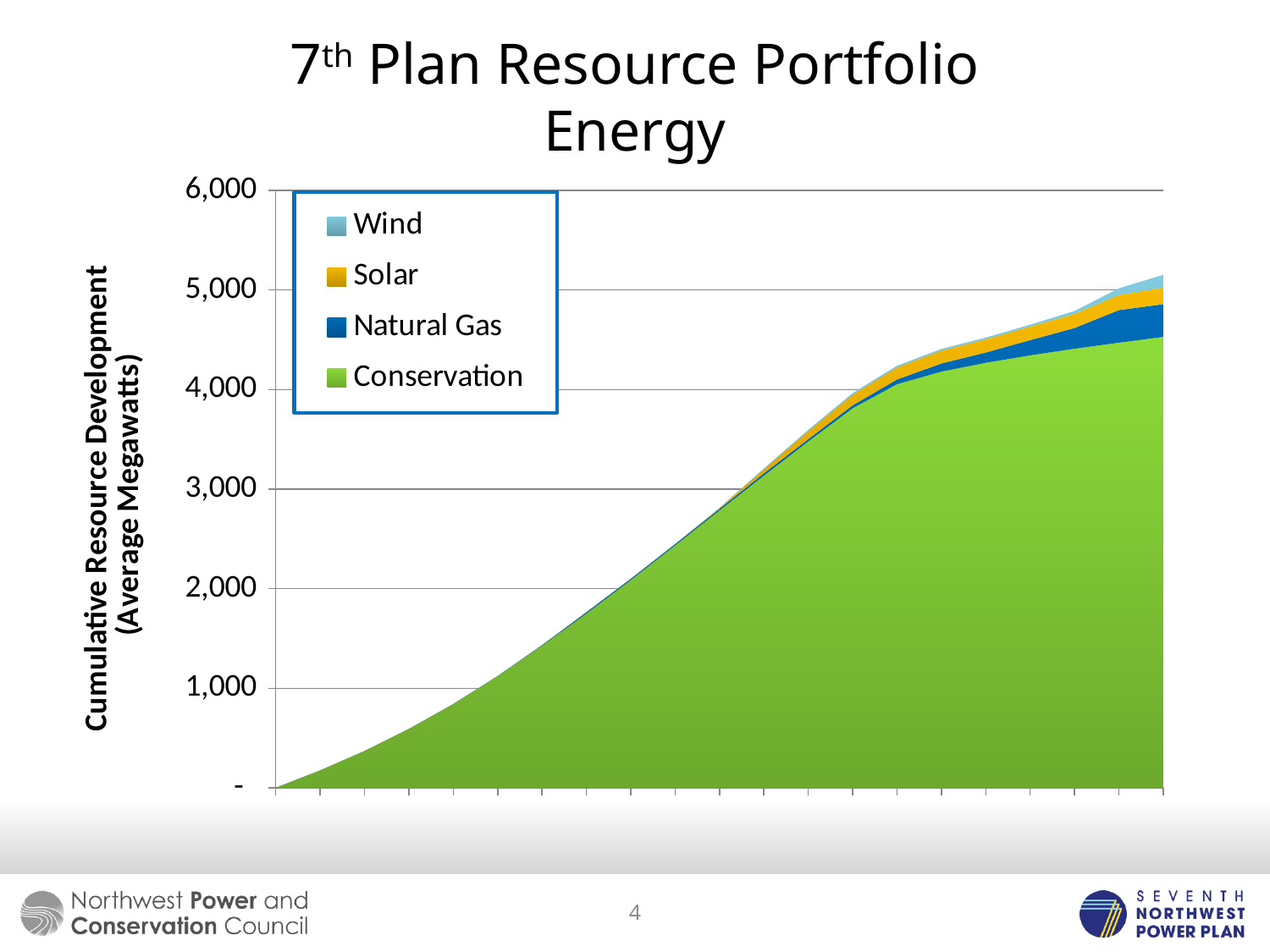
Which series accounts for the largest share of cumulative resource development? Conservation What is the title of the chart on the slide? 7th Plan Resource Portfolio Energy What is the highest value shown on the y axis? 6,000 Which is larger at the right end of the chart, Conservation or Natural Gas? Conservation Does the cumulative resource development rise or fall along the x axis? Rise Which series are listed in the legend? Wind, Solar, Natural Gas, Conservation Is the total cumulative resource development at the right end of the chart greater or less than 4,000? greater How many series does the legend list? 4 Is the total cumulative resource development at the right end of the chart greater or less than 6,000? less Is the Conservation value at the right end of the chart greater or less than 4,000? greater What kind of chart is shown on the slide? Stacked area chart